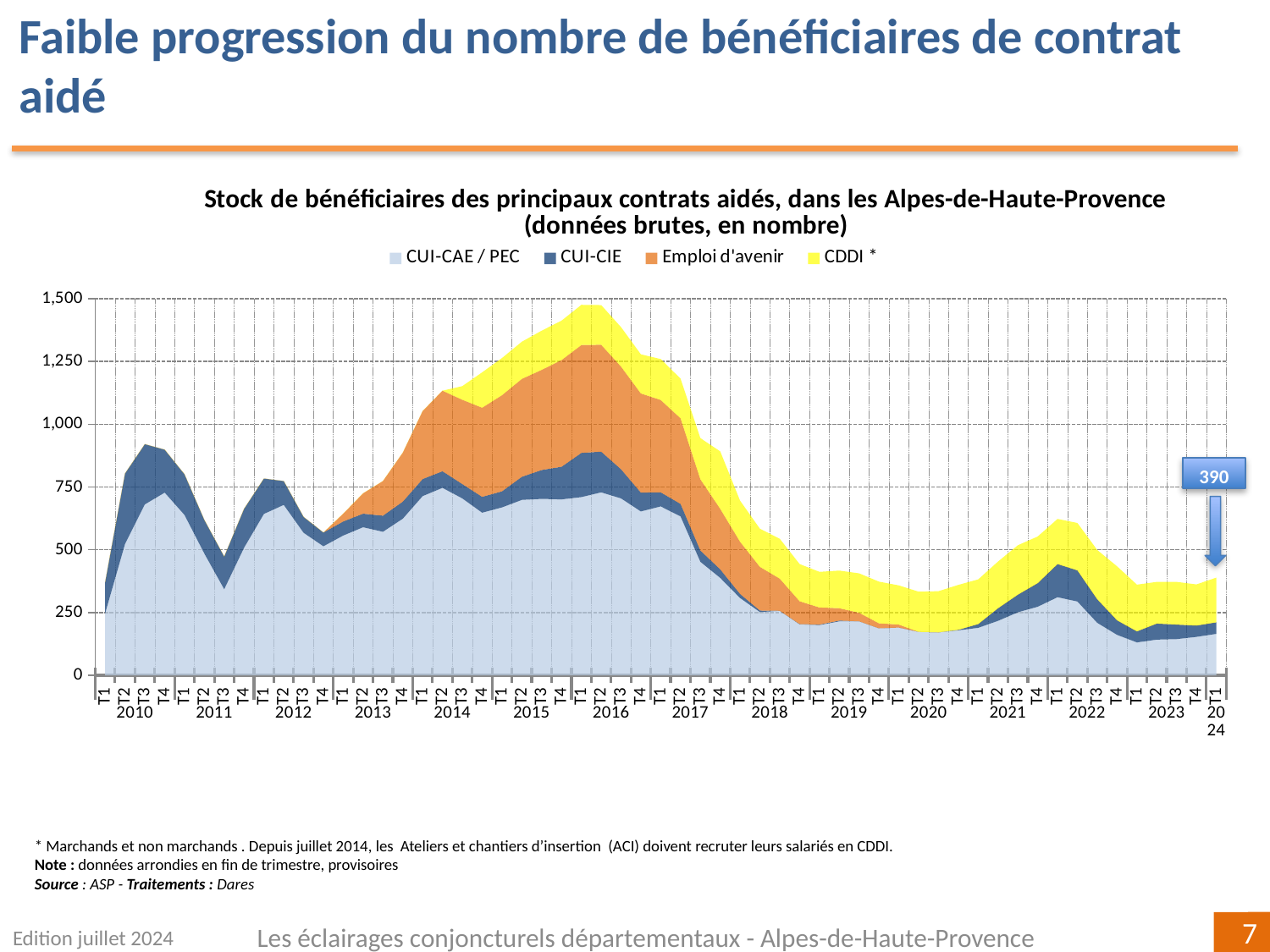
Is the total value at T1 2016 greater or less than 1,250? greater What value is shown by the data label at the end of the chart (T1 2024)? 390 Which is larger, the total at T1 2016 or the total at T1 2010? T1 2016 Is the total value at T1 2024 greater or less than 500? less Does the total stock of beneficiaries rise or fall between T1 2016 and T1 2020? Fall Is the total value at T1 2022 greater or less than 500? greater What kind of chart is shown on the slide? Stacked area chart How many years are labelled on the x axis? 15 In which year is the total stock of beneficiaries at its lowest? 2020 How many series does the chart legend list? 4 Which series is shown in yellow in the chart? CDDI *